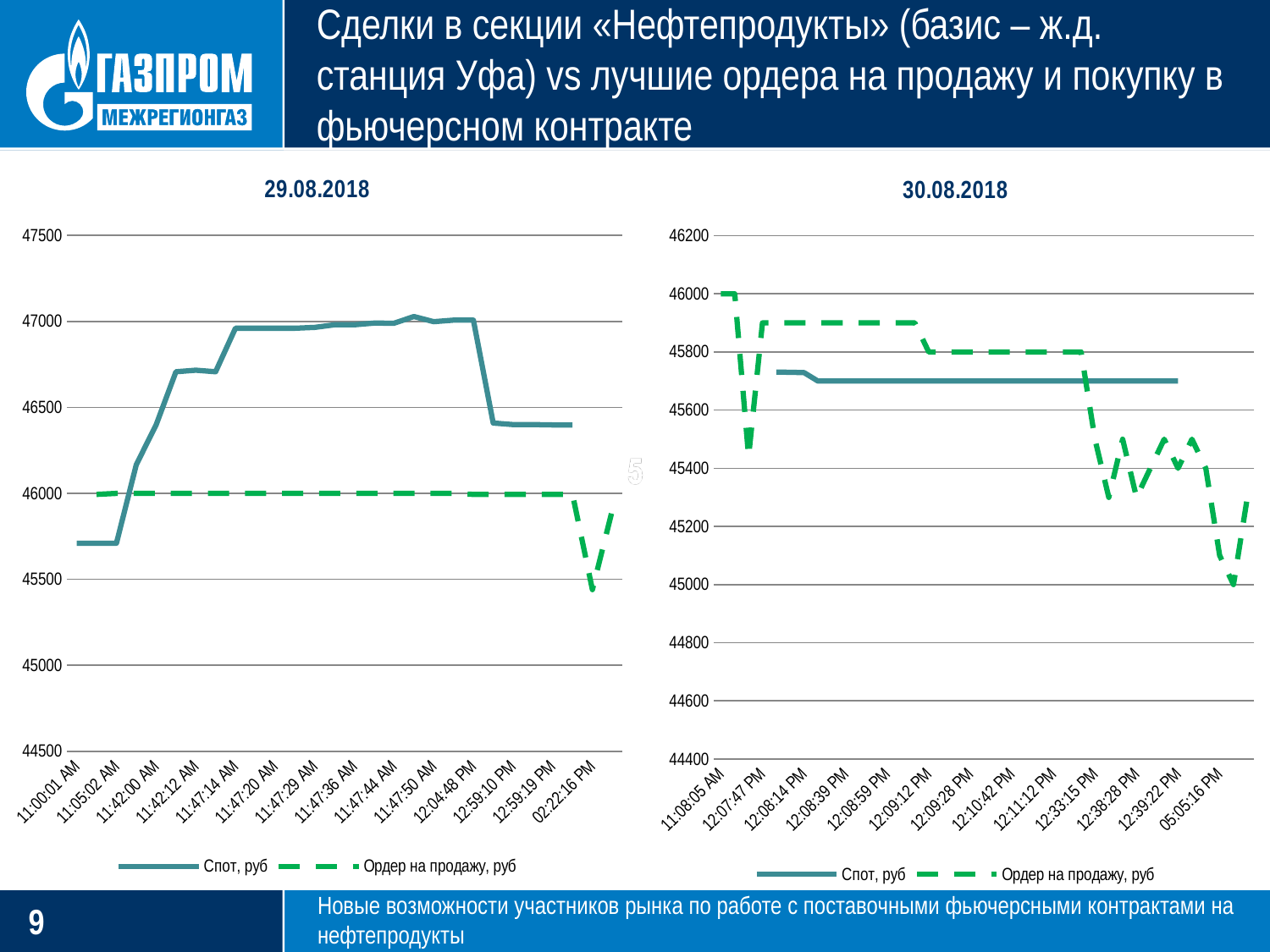
How many series does the legend of the chart titled 30.08.2018 list? 2 In the chart titled 30.08.2018, does the Ордер на продажу, руб series overall rise or fall from the first to the last point on the x axis? Fall In the chart titled 29.08.2018, which series is drawn with a dashed green line? Ордер на продажу, руб In the chart titled 29.08.2018, is the value of Ордер на продажу, руб at 02:22:16 PM greater or less than 46000? less In the chart titled 30.08.2018, is the value of Ордер на продажу, руб at 12:08:14 PM greater or less than 45800? greater In the chart titled 29.08.2018, is the value of Спот, руб at 11:00:01 AM greater or less than 46000? less What are the two series named in the legend of the chart titled 29.08.2018? Спот, руб and Ордер на продажу, руб In the chart titled 29.08.2018, which series has the higher value at 12:04:48 PM, Спот, руб or Ордер на продажу, руб? Спот, руб What kind of chart is the chart titled 29.08.2018? Line chart